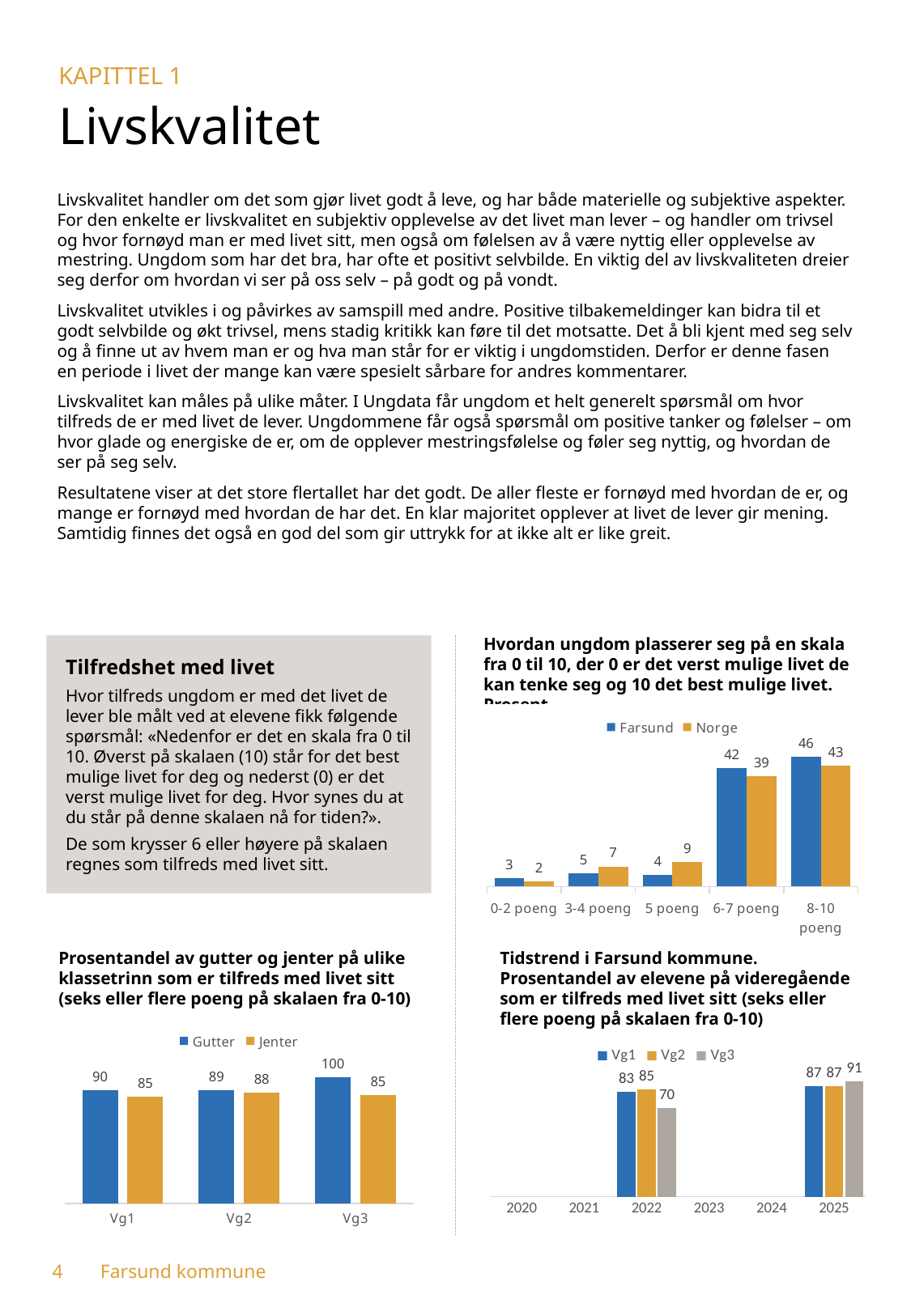
What kind of chart is the bottom-right chart (Tidstrend i Farsund kommune)? Bar chart In the bottom-left chart (Prosentandel av gutter og jenter på ulike klassetrinn), what is the difference between Gutter and Jenter at Vg1? 5 In the bottom-left chart (Prosentandel av gutter og jenter på ulike klassetrinn), how many series does the legend list? 2 In the top-right chart (Hvordan ungdom plasserer seg på en skala fra 0 til 10), which category has the highest value for Farsund? 8-10 poeng In the top-right chart (Hvordan ungdom plasserer seg på en skala fra 0 til 10), how many categories are shown on the x axis? 5 In the bottom-right chart (Tidstrend i Farsund kommune), what is the value for Vg3 in 2022? 70 In the top-right chart (Hvordan ungdom plasserer seg på en skala fra 0 til 10), what is the value for Farsund in the 6-7 poeng category? 42 In the top-right chart (Hvordan ungdom plasserer seg på en skala fra 0 til 10), what is the difference between Farsund and Norge in the 8-10 poeng category? 3 In the bottom-right chart (Tidstrend i Farsund kommune), which series has the highest value in 2025? Vg3 In the bottom-left chart (Prosentandel av gutter og jenter på ulike klassetrinn), what is the value for Gutter at Vg3? 100 In the bottom-left chart (Prosentandel av gutter og jenter på ulike klassetrinn), which is larger at Vg2, Gutter or Jenter? Gutter In the top-right chart (Hvordan ungdom plasserer seg på en skala fra 0 til 10), what is the value for Norge in the 5 poeng category? 9